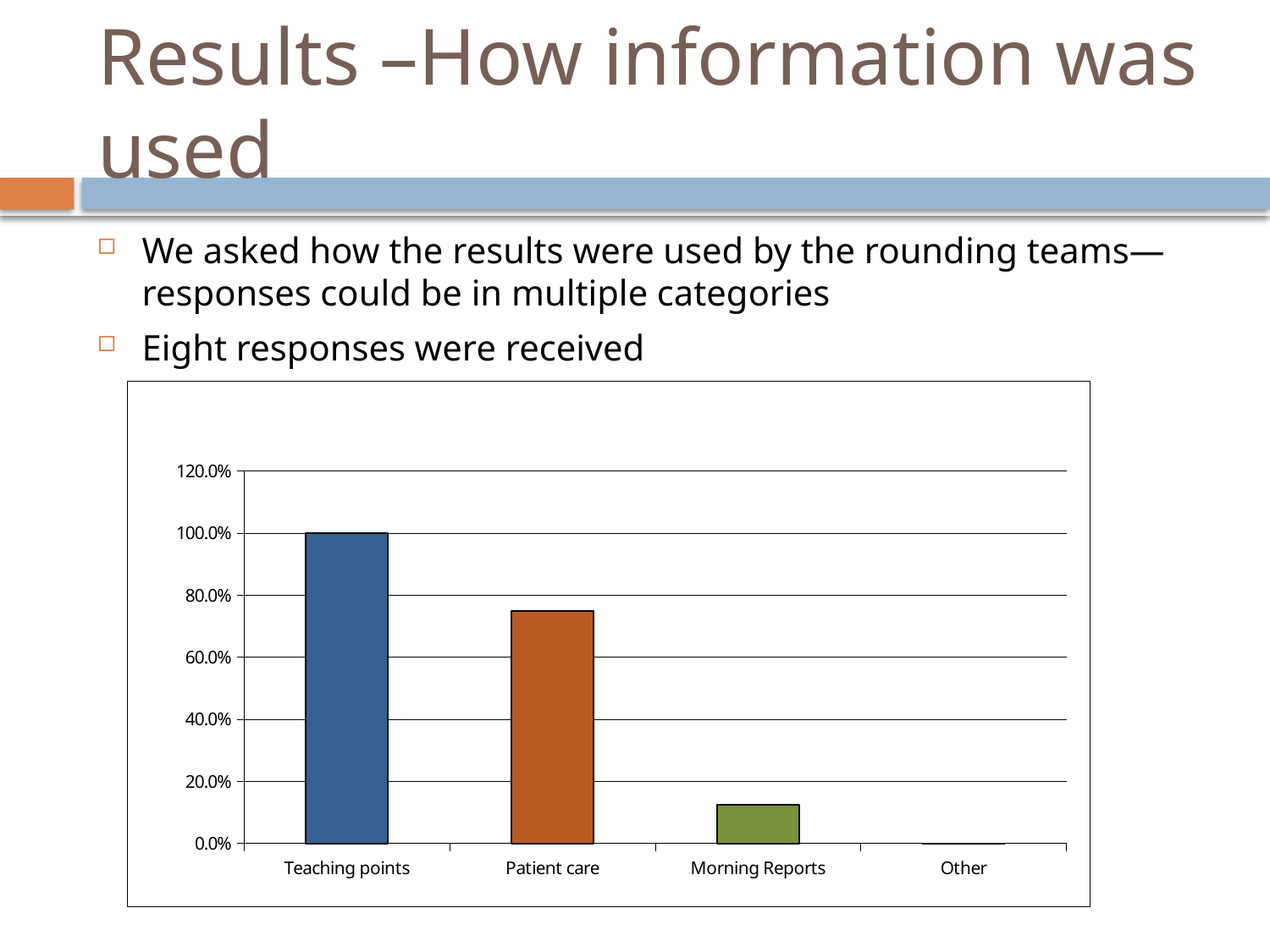
How many categories are shown on the x axis of the chart? 4 What is the highest value shown on the y axis of the chart? 120.0% What is the value for Teaching points? 100.0% Which category has the lowest value in the chart? Other Is the value for Patient care greater or less than 60.0%? greater Do the bar values rise or fall from left to right across the x axis? fall Which category has the highest value in the chart? Teaching points Is the value for Morning Reports greater or less than 20.0%? less Is the value for Patient care greater or less than 80.0%? less Which is larger, the value for Patient care or the value for Morning Reports? Patient care Which is larger, the value for Teaching points or the value for Patient care? Teaching points What kind of chart is shown on the slide? bar chart